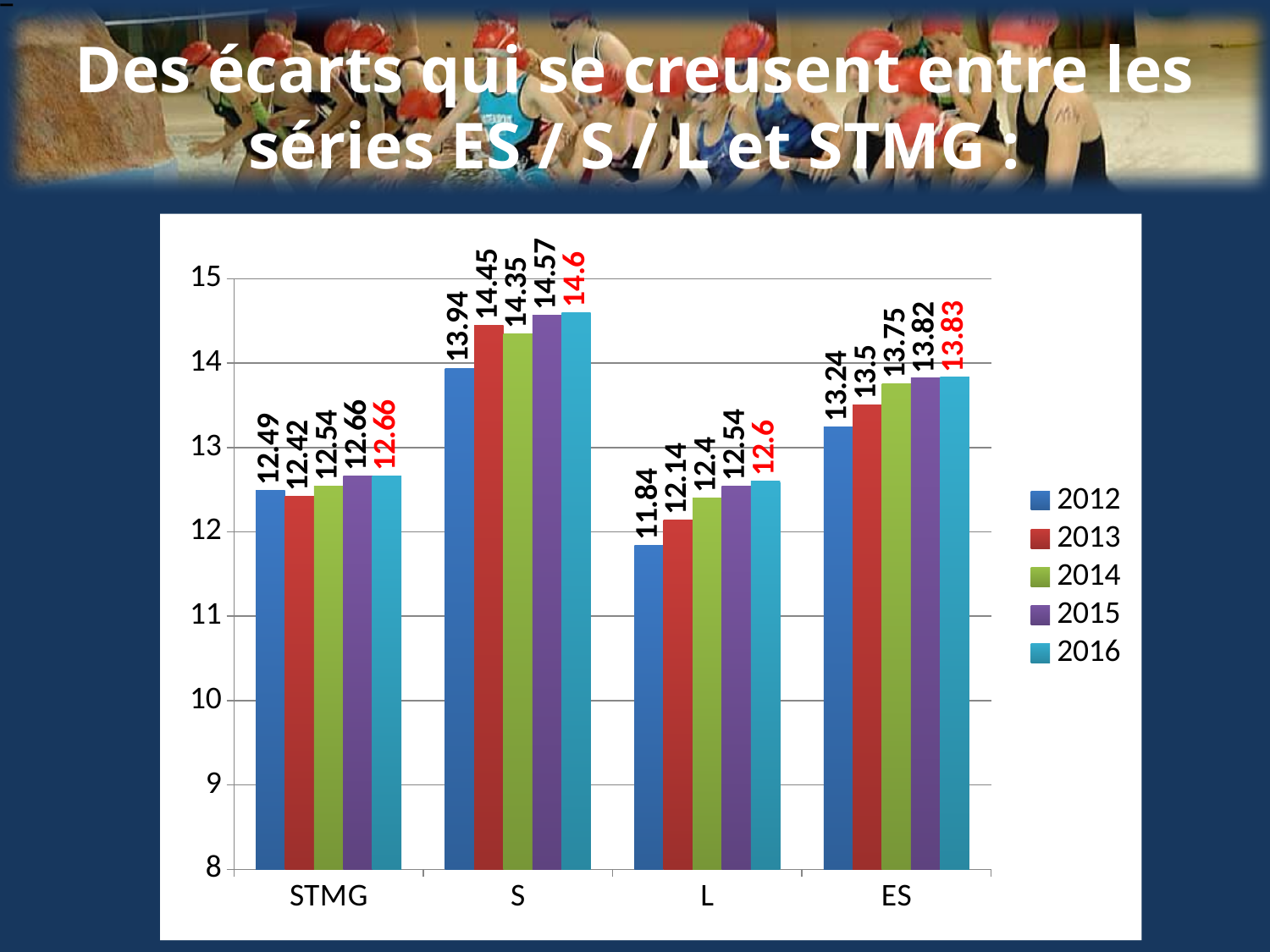
Is the 2013 value for L greater or less than 12? greater What is the value for L in 2012? 11.84 Which category has the lowest value in 2012? L Which is larger, the 2015 value for ES or the 2015 value for STMG? ES How many series does the legend list? 5 What kind of chart is shown on the slide? bar chart Which category has the highest value in 2016? S What is the value for S in 2016? 14.6 What is the difference between the 2016 values for S and L? 2 How many categories are shown on the x axis? 4 What is the value for ES in 2013? 13.5 What is the value for STMG in 2014? 12.54